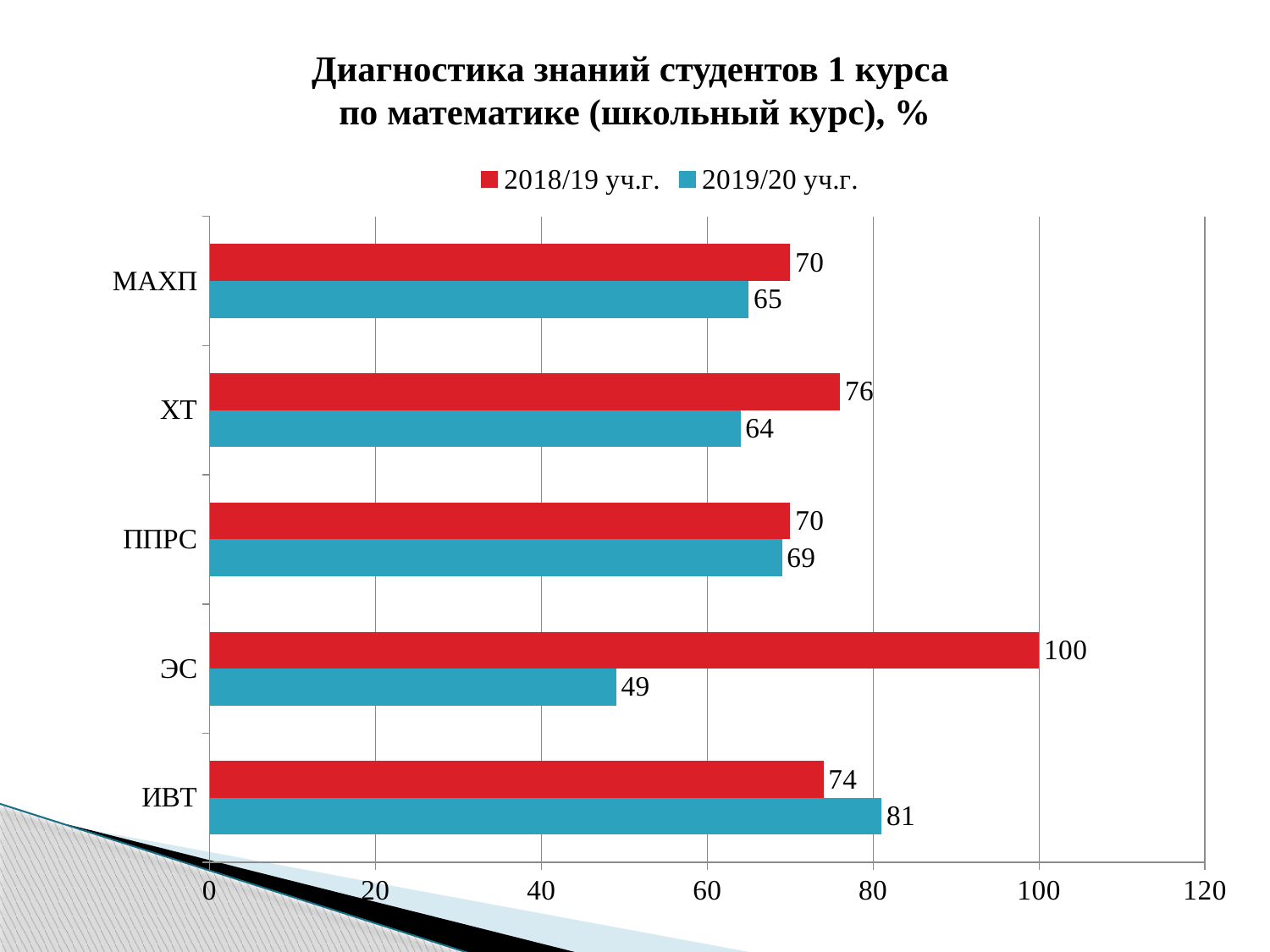
Is the 2019/20 уч.г. value for ЭС greater or less than 60? less How many categories are shown on the chart? 5 What is the value for ЭС in the 2018/19 уч.г. series? 100 Which category has the highest value in the 2018/19 уч.г. series? ЭС Which category has the lowest value in the 2019/20 уч.г. series? ЭС What is the value for ХТ in the 2019/20 уч.г. series? 64 Which is larger for ХТ: the 2018/19 уч.г. value or the 2019/20 уч.г. value? 2018/19 уч.г. What is the difference between the 2018/19 уч.г. and 2019/20 уч.г. values for ЭС? 51 What is the difference between the 2019/20 уч.г. and 2018/19 уч.г. values for ИВТ? 7 What is the value for ИВТ in the 2019/20 уч.г. series? 81 How many series does the legend list? 2 What kind of chart is shown on the slide? bar chart